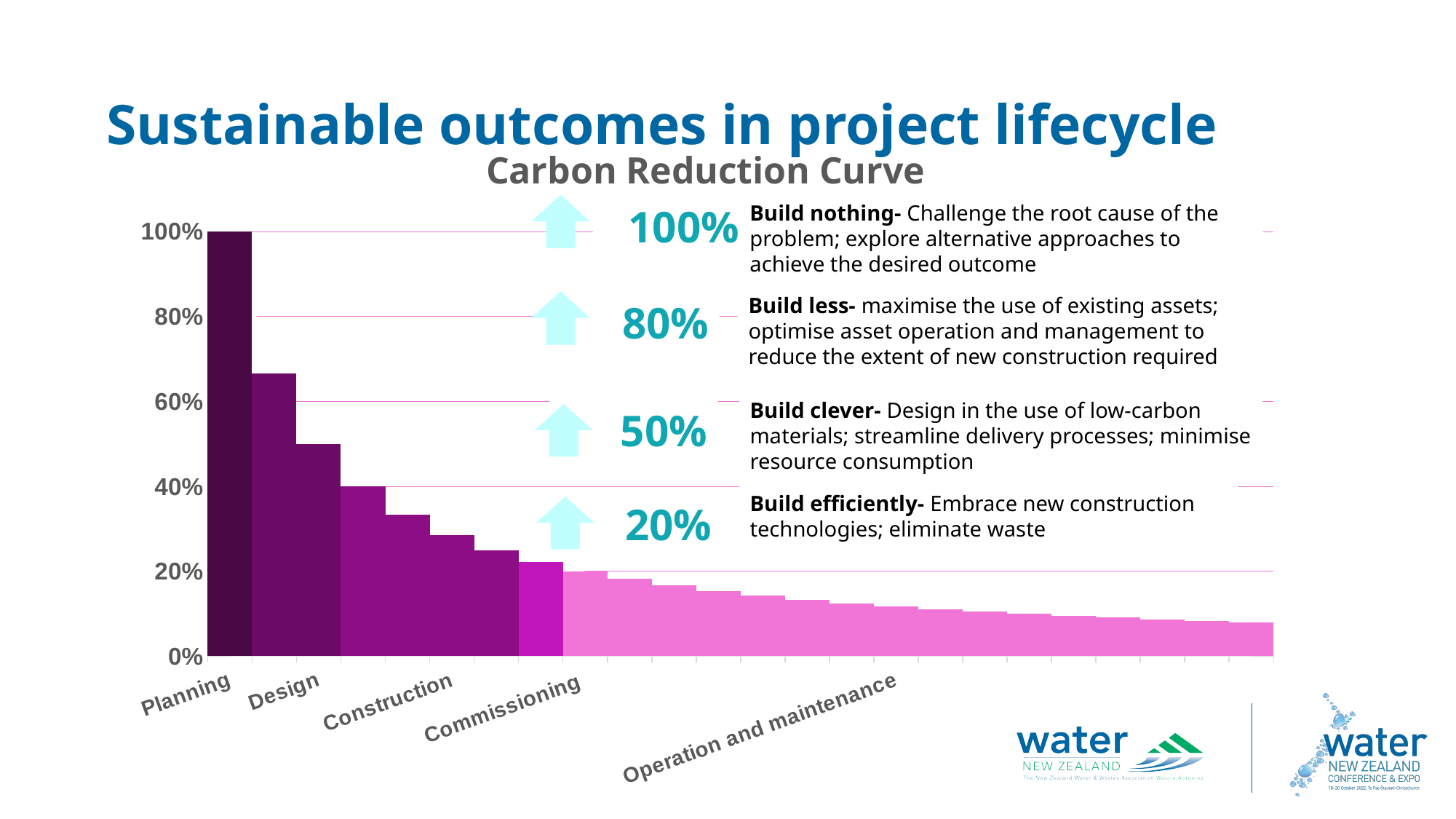
How many project phases are labelled on the x axis of the chart? 5 Are the bars for Construction greater or less than 60%? less What kind of chart is shown on the slide? bar chart Which project phase has the lowest bars in the chart? Operation and maintenance Is the Planning bar larger or smaller than the Commissioning bar? larger What value does the Planning bar reach on the y axis? 100% Do the bar values rise or fall moving from Planning to Operation and maintenance along the x axis? fall Which project phase has the tallest bar in the chart? Planning Are the bars for Operation and maintenance greater or less than 20%? less What is the highest value shown on the y axis of the chart? 100% What is the title of the chart? Carbon Reduction Curve Is the tallest Design bar greater or less than 60%? greater